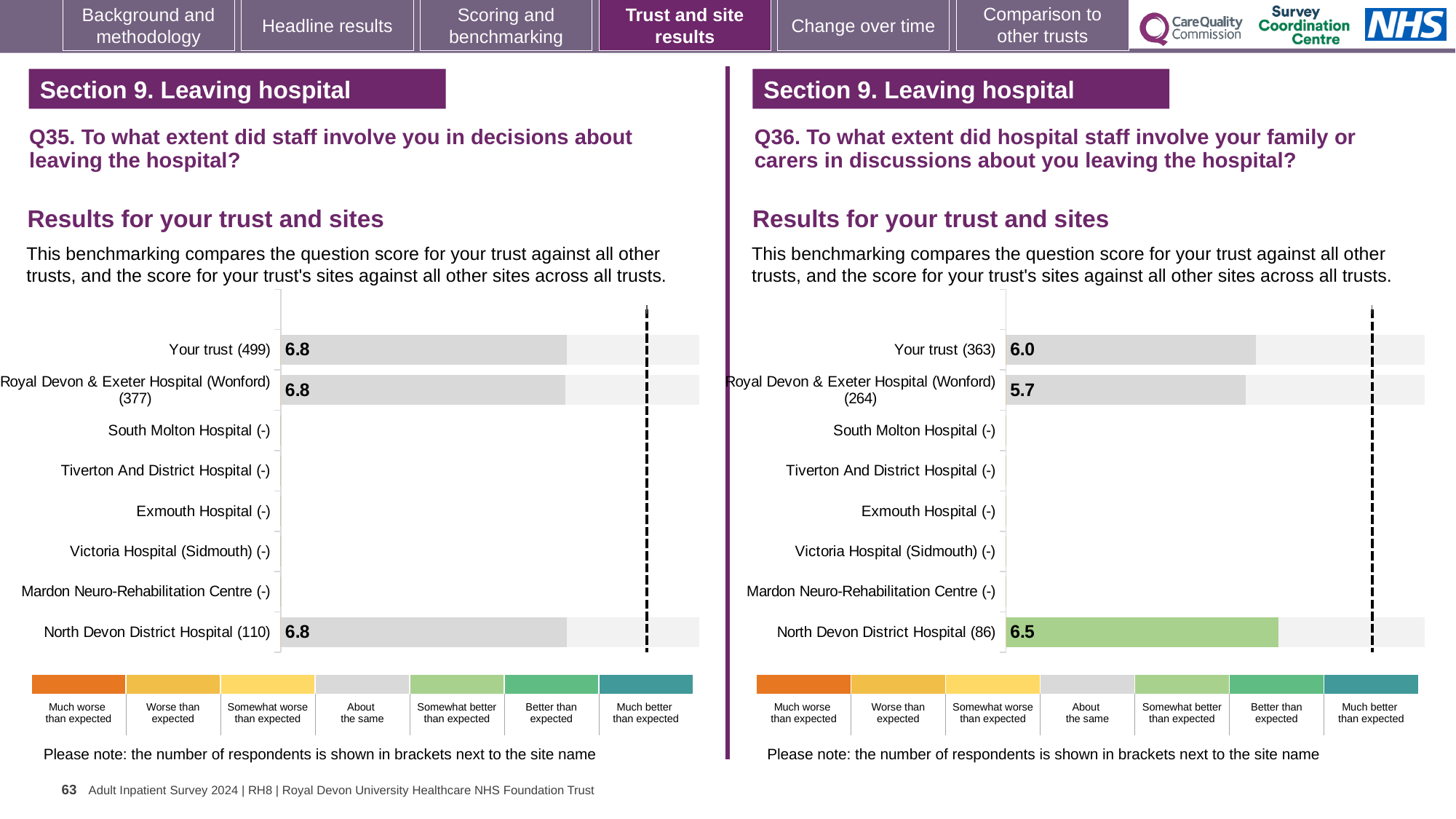
On the Q36 chart (right), what is the score for Your trust (363)? 6.0 On the Q36 chart (right), which site has the highest score? North Devon District Hospital (86) On the Q36 chart (right), which is larger: the score for Your trust (363) or for North Devon District Hospital (86)? North Devon District Hospital (86) On the Q35 chart (left), what is the score for North Devon District Hospital (110)? 6.8 On the Q36 chart (right), which benchmark category does the colour of the North Devon District Hospital (86) bar correspond to? Somewhat better than expected On the Q36 chart (right), what is the difference between the scores for North Devon District Hospital (86) and Royal Devon & Exeter Hospital (Wonford) (264)? 0.8 On the Q36 chart (right), what is the score for Royal Devon & Exeter Hospital (Wonford) (264)? 5.7 How many site or trust categories are listed on the Q35 chart (left)? 8 On the Q36 chart (right), what is the score for North Devon District Hospital (86)? 6.5 On the Q36 chart (right), which site has the lowest score? Royal Devon & Exeter Hospital (Wonford) (264) What type of chart is used on the Q35 chart (left)? Bar chart On the Q35 chart (left), what is the score for Your trust (499)? 6.8